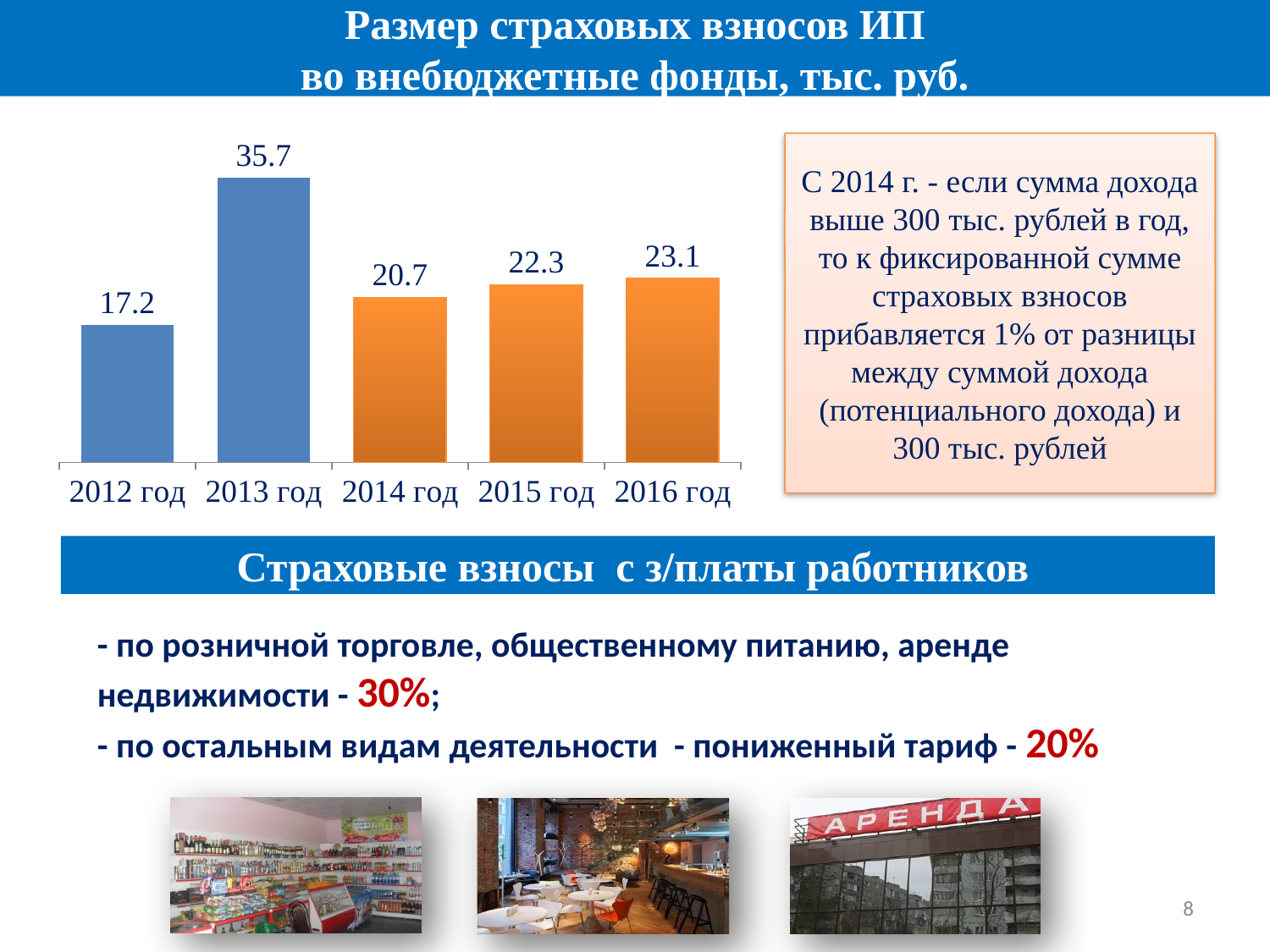
What is the difference between the values for 2013 год and 2014 год? 15.0 Which is larger, the value for 2014 год or the value for 2015 год? 2015 год What colour are the bars for 2012 год and 2013 год? blue Which year has the lowest value? 2012 год What is the value for 2012 год? 17.2 What is the value for 2016 год? 23.1 How many years are shown on the chart? 5 What is the difference between the values for 2016 год and 2012 год? 5.9 What kind of chart is shown on the slide? bar chart Do the values rise or fall from 2014 год to 2016 год? rise Which year has the highest value? 2013 год What is the value for 2013 год? 35.7